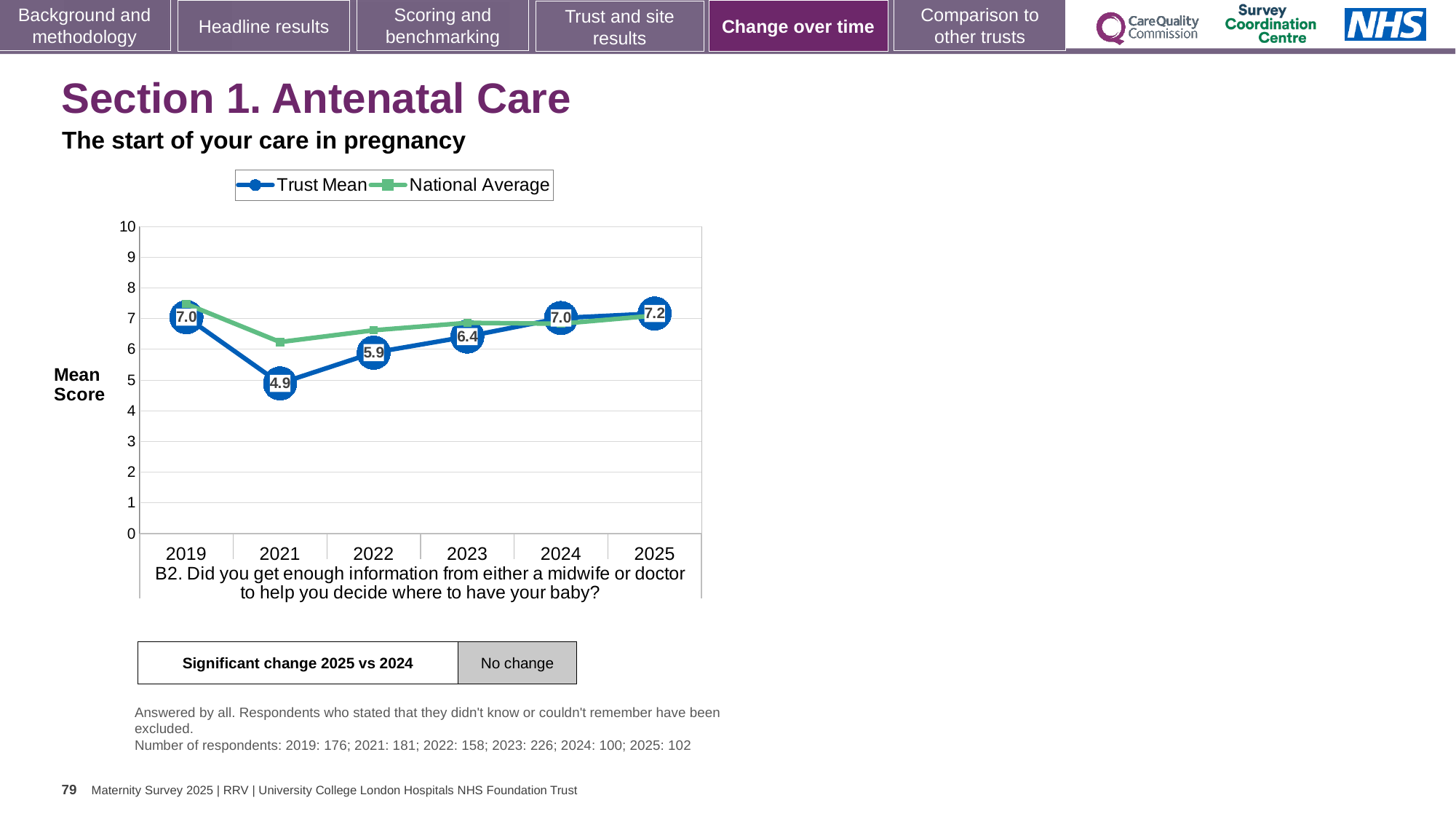
Which is larger, the Trust Mean score for 2022 or for 2023? 2023 What is the difference between the Trust Mean scores for 2025 and 2021? 2.3 In which year is the Trust Mean score lowest? 2021 How many series does the legend list? 2 What kind of chart is shown on the slide? line chart What is the Trust Mean score for 2023? 6.4 Does the Trust Mean score rise or fall from 2021 to 2025? rise Is the National Average value for 2021 greater or less than 7? less How many years are shown on the x axis? 6 What is the Trust Mean score for 2025? 7.2 In which year is the Trust Mean score highest? 2025 What is the Trust Mean score for 2021? 4.9